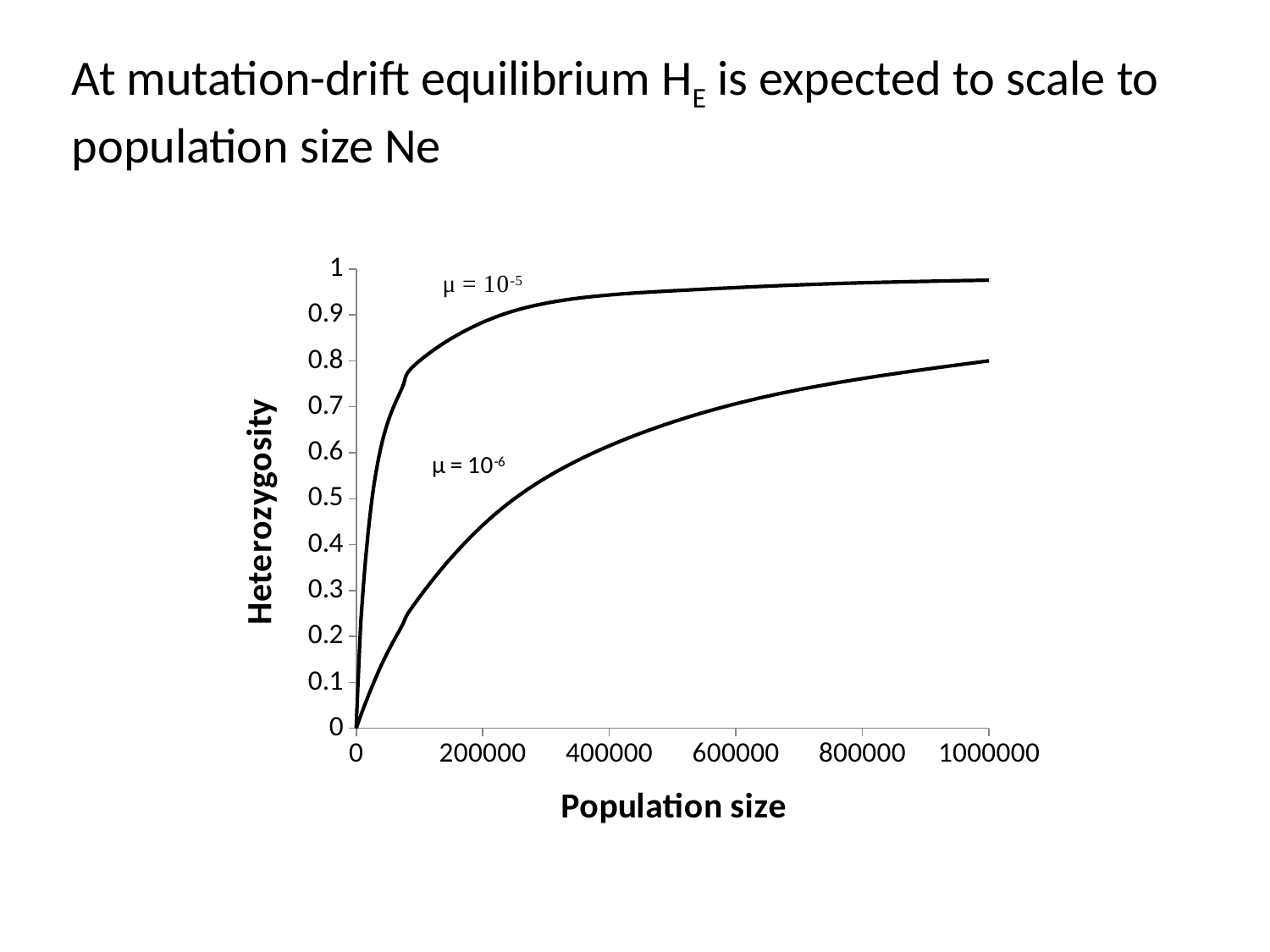
What kind of chart is shown on the slide? line chart Is the heterozygosity for the μ = 10^-6 curve at a population size of 200000 greater or less than 0.3? greater Is the heterozygosity for the μ = 10^-6 curve at a population size of 400000 greater or less than 0.7? less Is the heterozygosity for the μ = 10^-6 curve at a population size of 1000000 greater or less than 0.7? greater What is the label of the y axis? Heterozygosity Does heterozygosity rise or fall as population size increases along the x axis? rise How many curves are plotted on the chart? 2 Which curve is higher at a population size of 600000, μ = 10^-5 or μ = 10^-6? μ = 10^-5 What is the label of the x axis? Population size